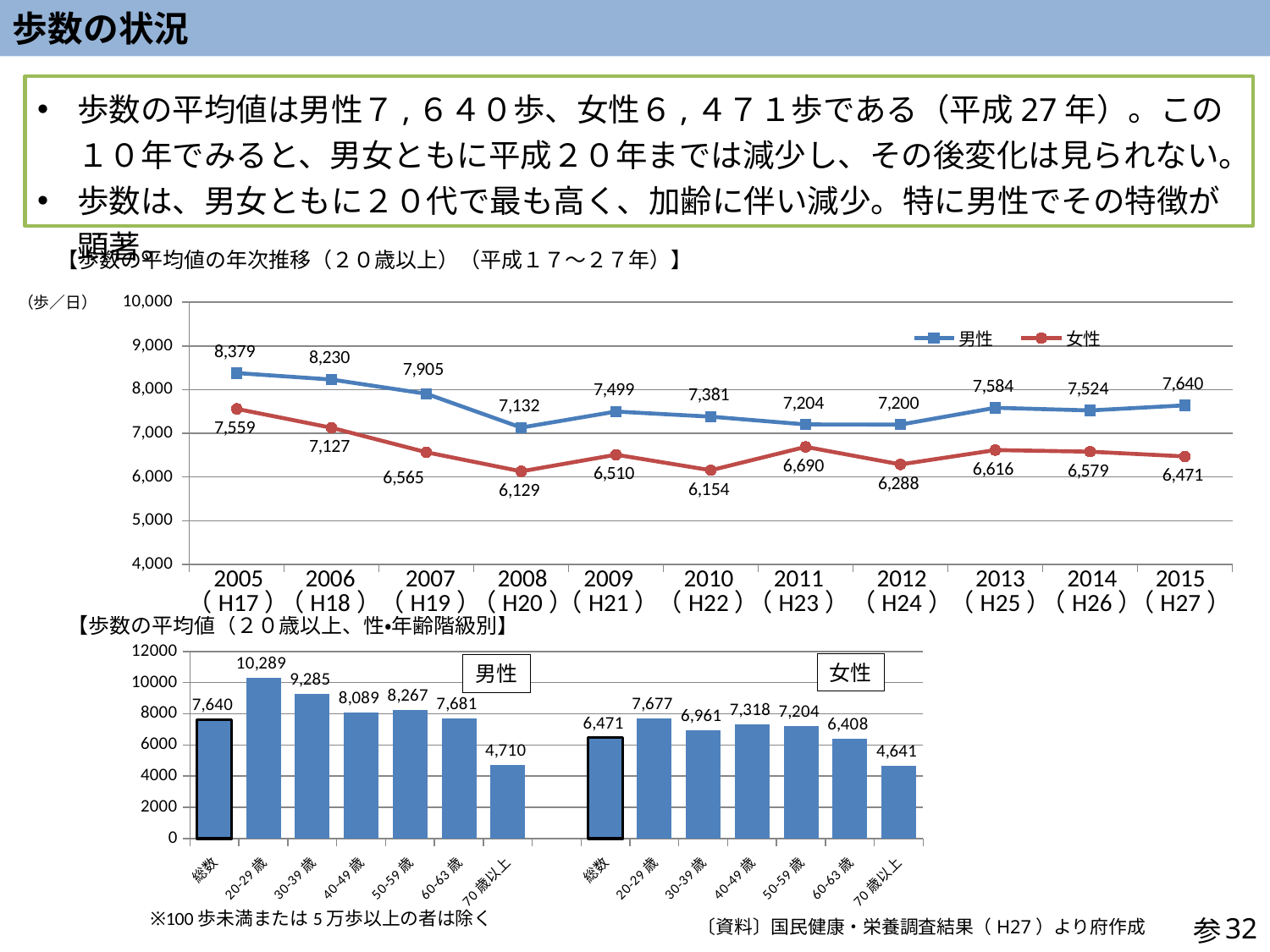
In the top line chart, which year has the lowest value for 男性? 2008 (H20) In the bottom bar chart, what is the value for 男性 20-29歳? 10,289 In the bottom bar chart, which age group has the lowest value for 女性? 70歳以上 What kind of chart is the bottom chart (歩数の平均値 性・年齢階級別)? bar chart In the bottom bar chart, what is the difference between 女性 総数 and 女性 70歳以上? 1,830 In the top line chart, what is the value for 女性 in 2008 (H20)? 6,129 In the top line chart, how many years are plotted on the x axis? 11 In the top line chart, do the 男性 values rise or fall from 2005 to 2008? fall In the top line chart (歩数の平均値の年次推移), what is the value for 男性 in 2005 (H17)? 8,379 In the bottom bar chart, which is larger: 男性 40-49歳 or 男性 50-59歳? 男性 50-59歳 In the top line chart, what is the difference between the 男性 and 女性 values in 2015 (H27)? 1,169 In the top line chart, how many series does the legend list? 2